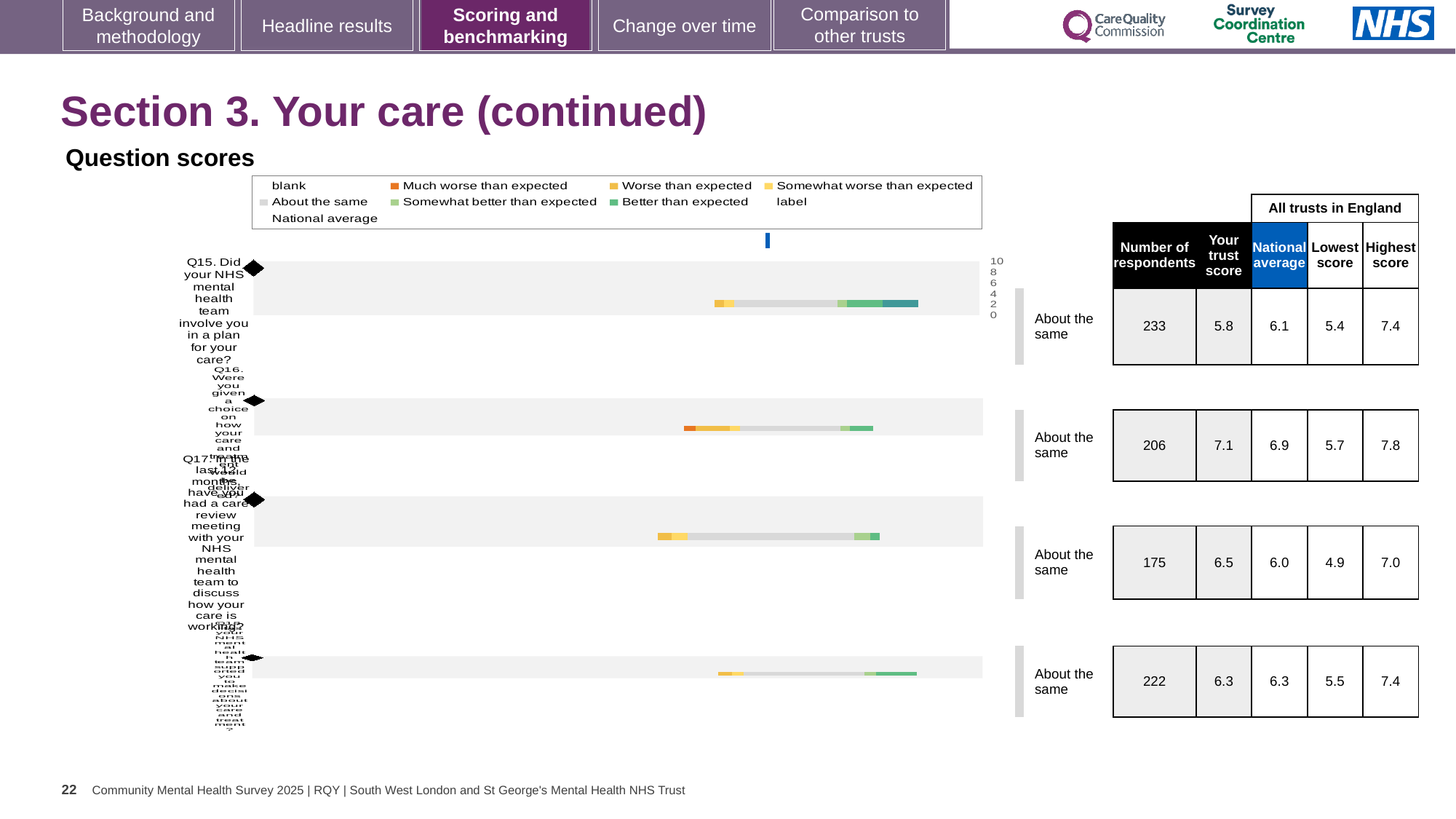
In the table beside the chart, how many respondents answered Q17 (care review meeting with your NHS mental health team)? 175 What kind of chart is used to show the question scores on this slide? bar chart Which question in the table has the lowest number of respondents? Q17 How many questions (bars) are plotted in the question scores chart? 4 In the table, what is the difference between the highest score and the lowest score for Q15? 2.0 Which question in the table has the highest number of respondents? Q15 In the table beside the chart, what is the trust score for Q15 (Did your NHS mental health team involve you in a plan for your care?)? 5.8 In the question scores chart, what colour does the legend use for 'Better than expected'? green In the table beside the chart, what is the national average for Q16 (Were you given a choice on how your care and treatment would be delivered)? 6.9 What benchmark category is shown next to the bar for Q15 in the question scores chart? About the same In the question scores chart, what colour does the legend use for 'Much worse than expected'? orange For Q16, is the trust score or the national average higher in the table? trust score